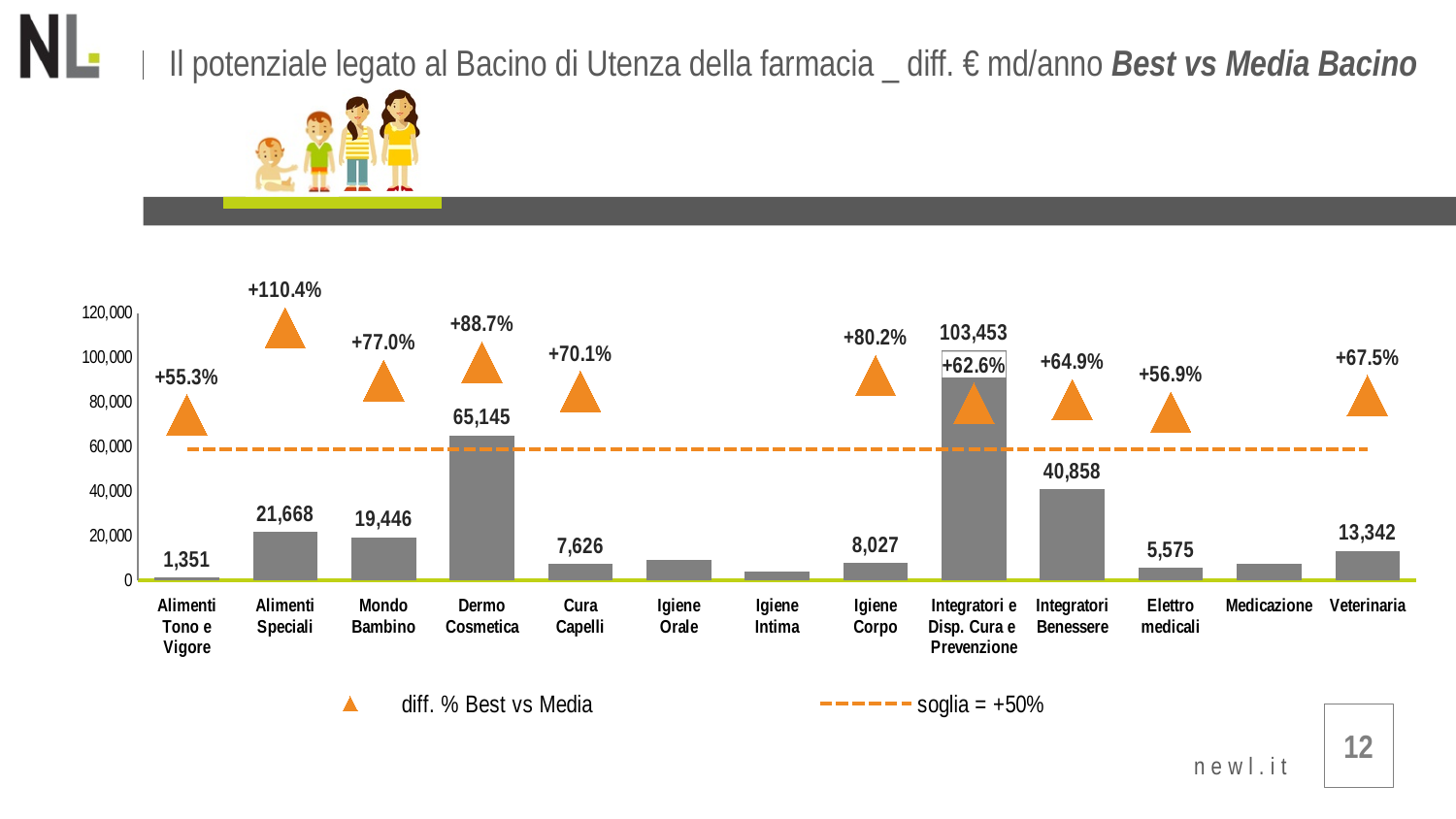
Which category has the highest diff. % Best vs Media? Alimenti Speciali How many categories are shown on the x axis? 13 Which category has the tallest bar? Integratori e Disp. Cura e Prevenzione Which is larger, the value for Alimenti Speciali or the value for Mondo Bambino? Alimenti Speciali What is the diff. % Best vs Media shown for Alimenti Speciali? +110.4% What is the difference between the values for Alimenti Speciali and Mondo Bambino? 2,222 What is the value shown for Veterinaria? 13,342 Which category has the lowest diff. % Best vs Media shown? Alimenti Tono e Vigore What does the dashed orange line represent according to the legend? soglia = +50% What is the value shown for Dermo Cosmetica? 65,145 Is the value for Igiene Orale greater or less than 20,000? less What is the difference between the values for Integratori e Disp. Cura e Prevenzione and Integratori Benessere? 62,595